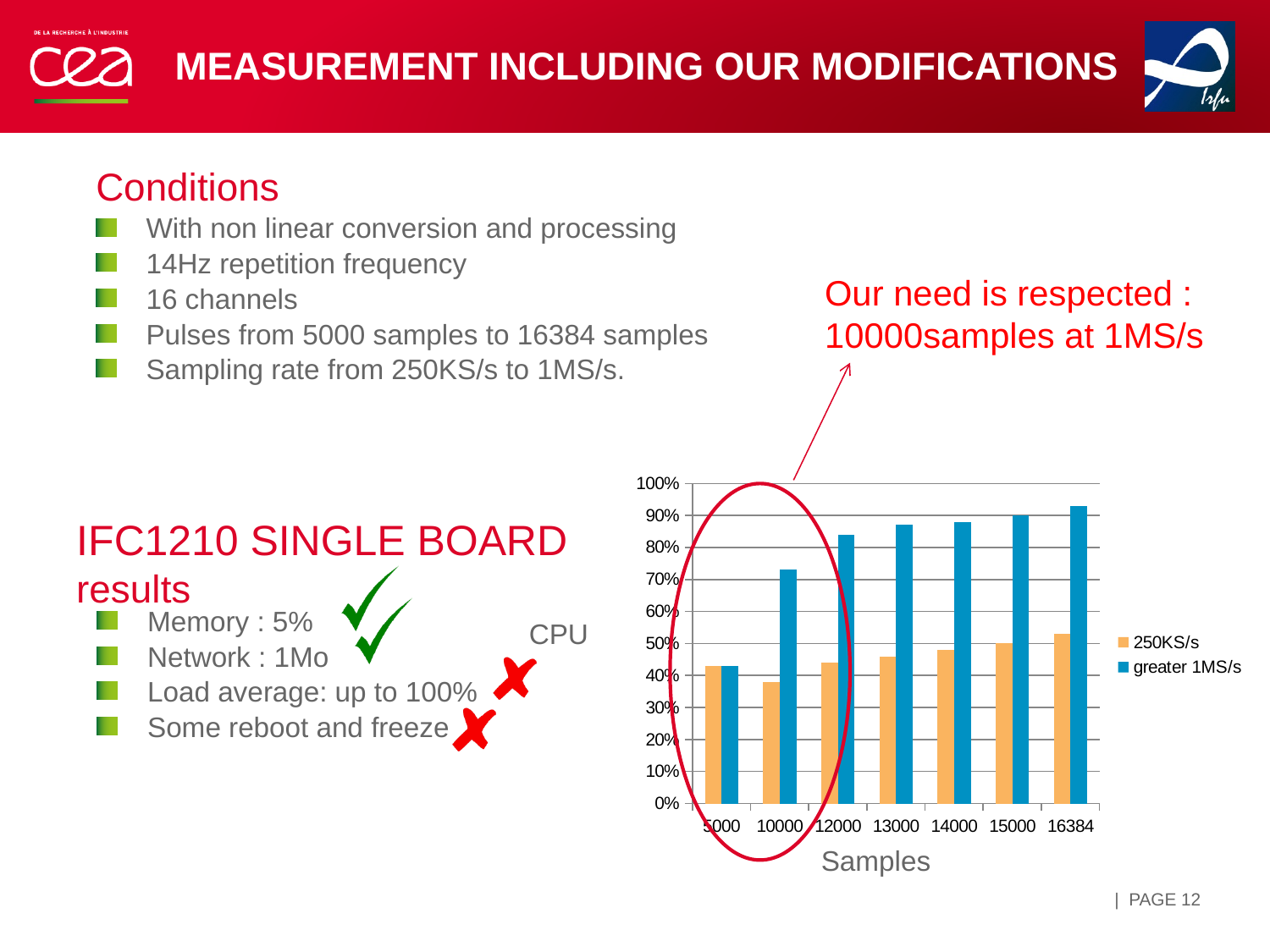
What is the x-axis title of the chart? Samples For the greater 1MS/s series, which sample size has the highest value? 16384 For the 250KS/s series, which sample size has the lowest value? 10000 Is the value for 250KS/s at 10000 samples greater or less than 40%? less How many sample-size categories are shown on the x axis of the chart? 7 Is the value for greater 1MS/s at 16384 samples greater or less than 90%? greater Is the value for greater 1MS/s at 10000 samples greater or less than 70%? greater What kind of chart is shown on the slide? bar chart At 12000 samples, which series has the larger value, 250KS/s or greater 1MS/s? greater 1MS/s Which series is shown in blue in the chart? greater 1MS/s How many series does the chart legend list? 2